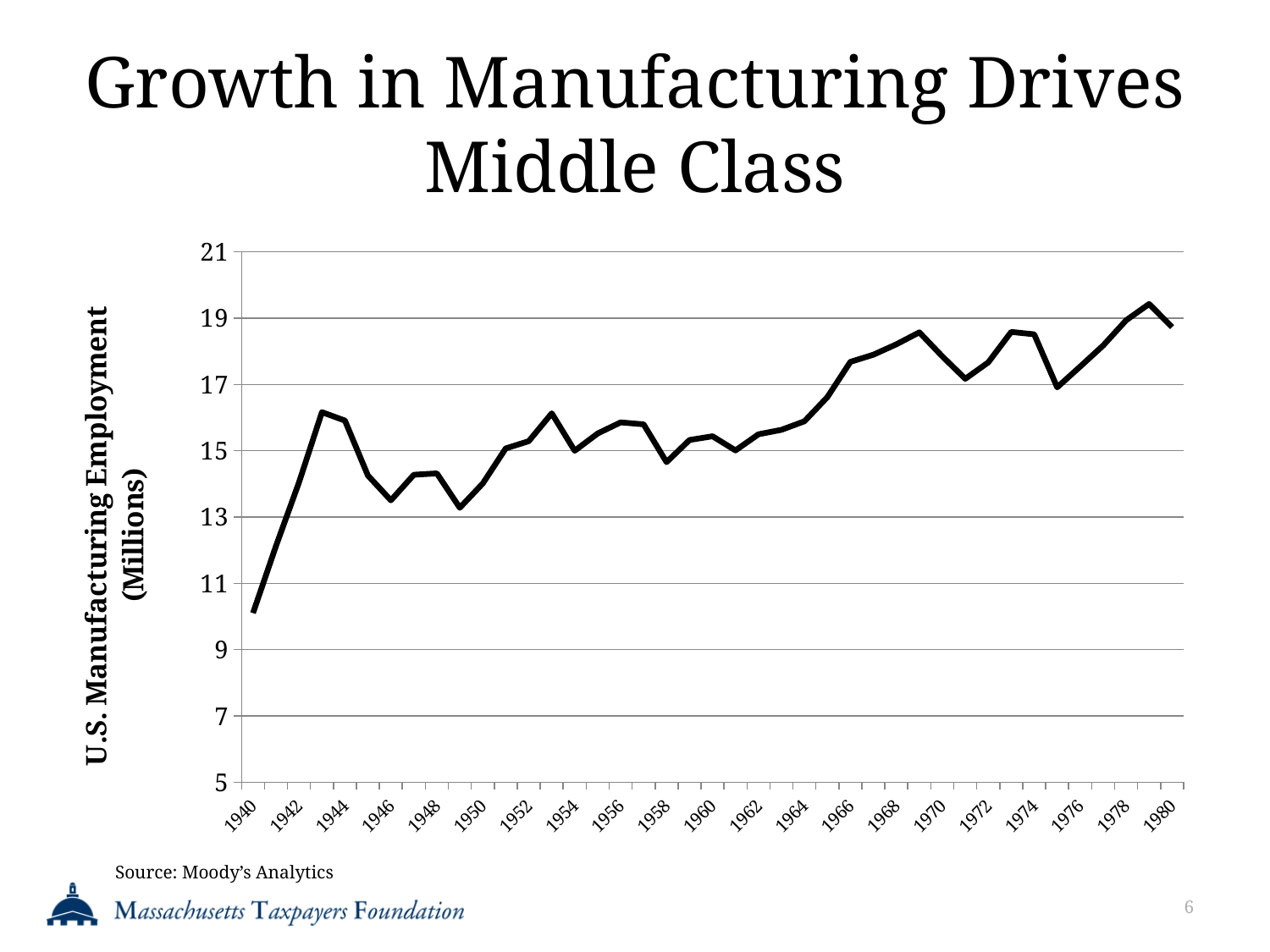
Is the value for 1979 greater or less than 19? greater What is the label on the vertical axis of the chart? U.S. Manufacturing Employment (Millions) Which year has the highest U.S. manufacturing employment on the chart? 1979 Which year has the larger value, 1940 or 1980? 1980 Overall, does U.S. manufacturing employment rise or fall from 1940 to 1980? rise Is the value for 1958 greater or less than 15? less Is the value for 1943 greater or less than 15? greater Which year has the lowest U.S. manufacturing employment on the chart? 1940 What kind of chart is shown on the slide? line chart Which year has the larger value, 1943 or 1946? 1943